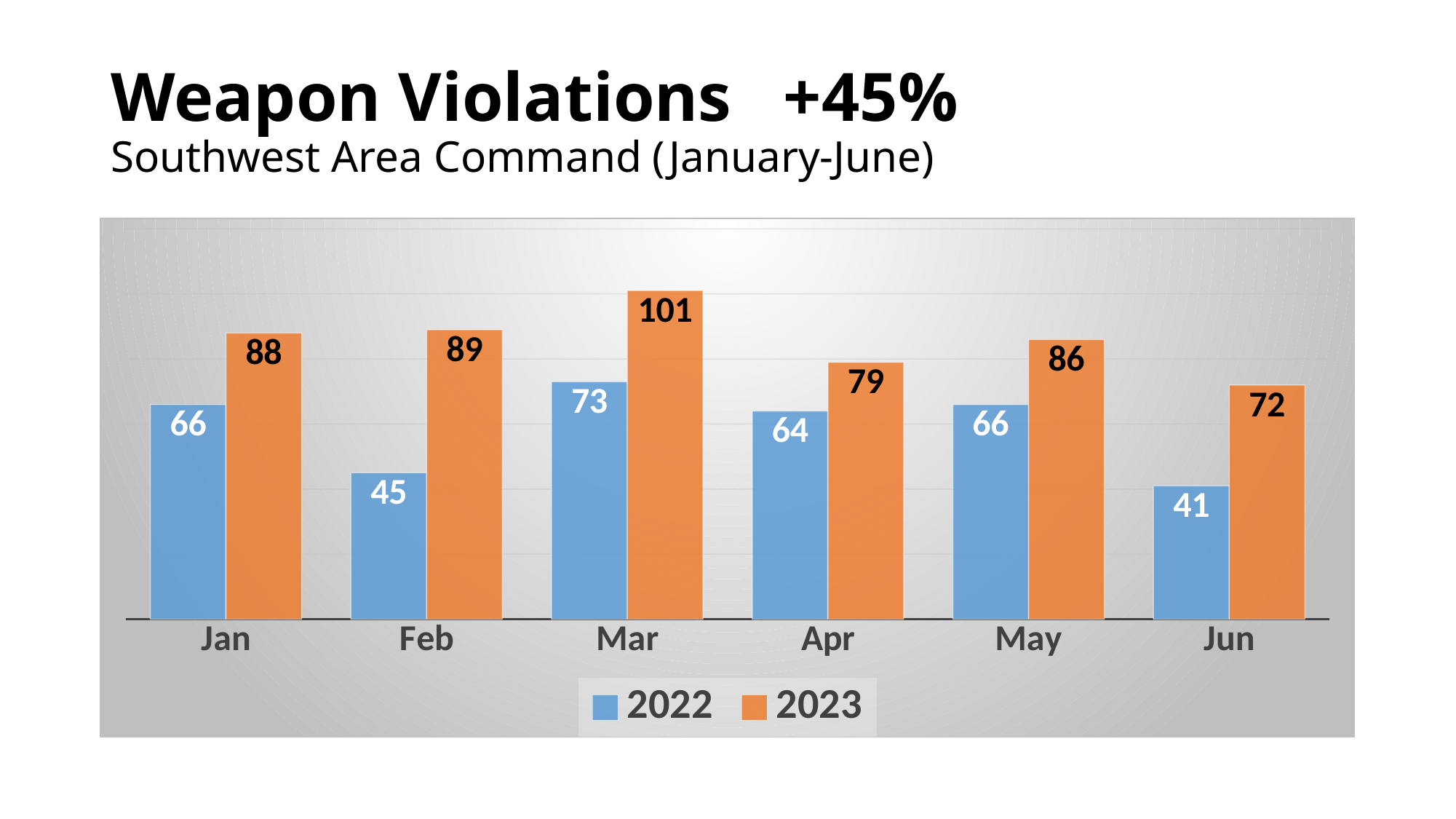
How many series does the legend list? 2 Which month has the highest value for 2023? Mar Which month has the lowest value for 2022? Jun What is the value for 2023 in June? 72 How many months are shown on the x axis? 6 What is the difference between the 2023 and 2022 values in February? 44 What colour represents the 2023 series? Orange What is the difference between the 2023 values for March and June? 29 Which is larger, the 2022 value for March or the 2022 value for May? March What kind of chart is shown on the slide? Bar chart What is the value for 2022 in February? 45 What is the value for 2023 in March? 101